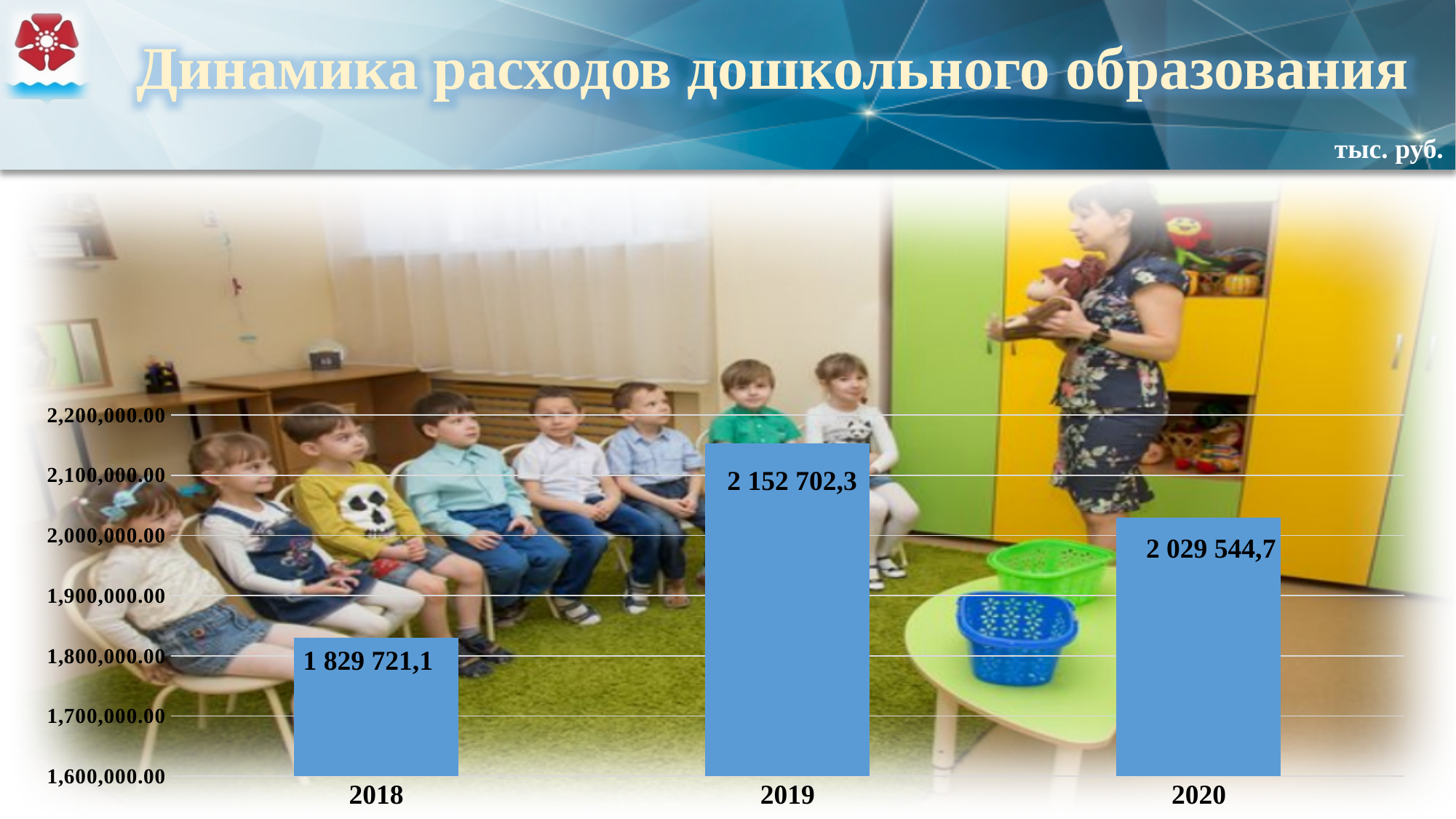
Which year has the highest expenditure? 2019 What unit of measurement is indicated for the chart? тыс. руб. What is the difference between the values for 2019 and 2018? 322 981,2 What is the value for 2019? 2 152 702,3 What is the difference between the values for 2019 and 2020? 123 157,6 How many years are shown on the chart? 3 Which is larger, the value for 2020 or the value for 2018? 2020 Which year has the lowest expenditure? 2018 Is the value for 2018 greater or less than 1,900,000.00? less What is the value for 2018? 1 829 721,1 What is the value for 2020? 2 029 544,7 What kind of chart is shown on the slide? bar chart